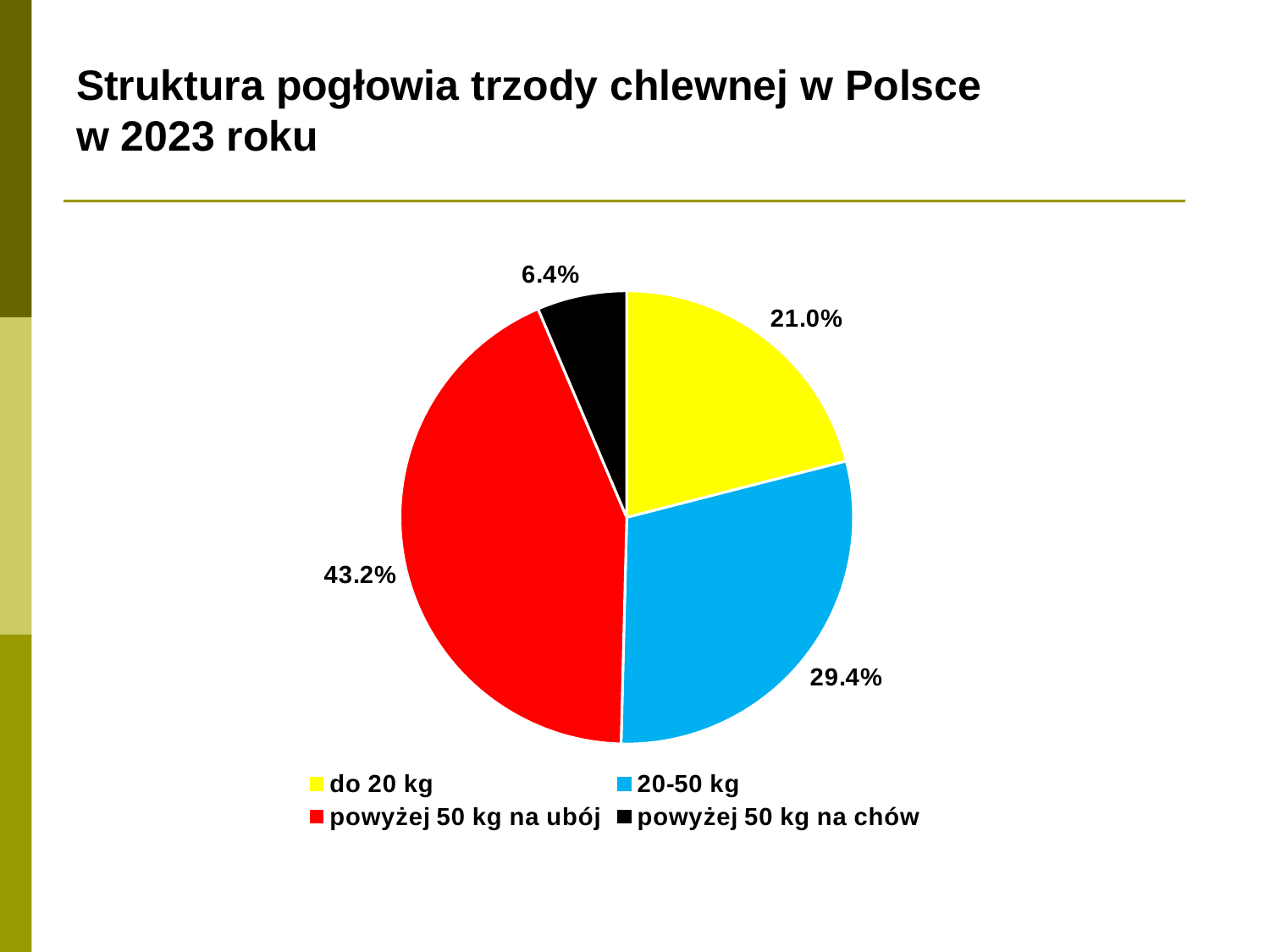
What share of the pie does the '20-50 kg' slice represent? 29.4% What is the difference in percentage points between the 'powyżej 50 kg na ubój' slice and the '20-50 kg' slice? 13.8 Which category has the smallest slice of the pie? powyżej 50 kg na chów What share of the pie does the 'powyżej 50 kg na ubój' slice represent? 43.2% What share of the pie does the 'powyżej 50 kg na chów' slice represent? 6.4% Which is larger: the '20-50 kg' slice or the 'do 20 kg' slice? 20-50 kg What colour is the slice for 'powyżej 50 kg na ubój'? red Which category has the largest slice of the pie? powyżej 50 kg na ubój What is the title of the slide containing the chart? Struktura pogłowia trzody chlewnej w Polsce w 2023 roku How many categories does the pie chart show? 4 What kind of chart is shown on the slide? pie chart